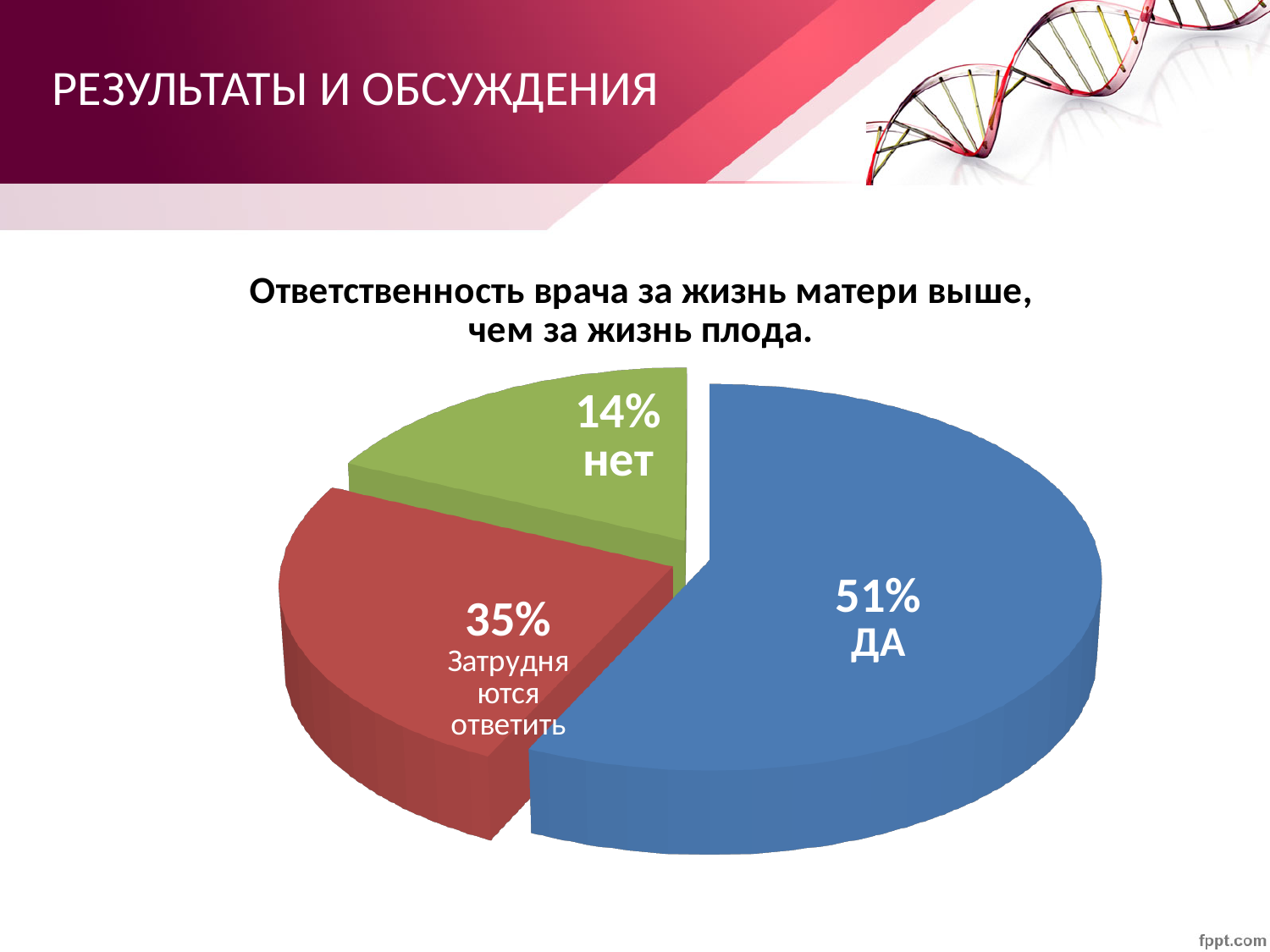
What share of the pie does the "нет" slice represent? 14% Which is larger: the "Затрудняются ответить" slice or the "нет" slice? Затрудняются ответить What is the difference in percentage points between the "ДА" slice and the "нет" slice? 37 Which slice of the pie is the largest? ДА What is the difference in percentage points between the "Затрудняются ответить" slice and the "нет" slice? 21 What is the title of the chart? Ответственность врача за жизнь матери выше, чем за жизнь плода. What kind of chart is shown on the slide? Pie chart What share of the pie does the "Затрудняются ответить" slice represent? 35% How many slices does the pie chart have? 3 What colour is the "ДА" slice of the pie? Blue What share of the pie does the "ДА" slice represent? 51% Which slice of the pie is the smallest? нет